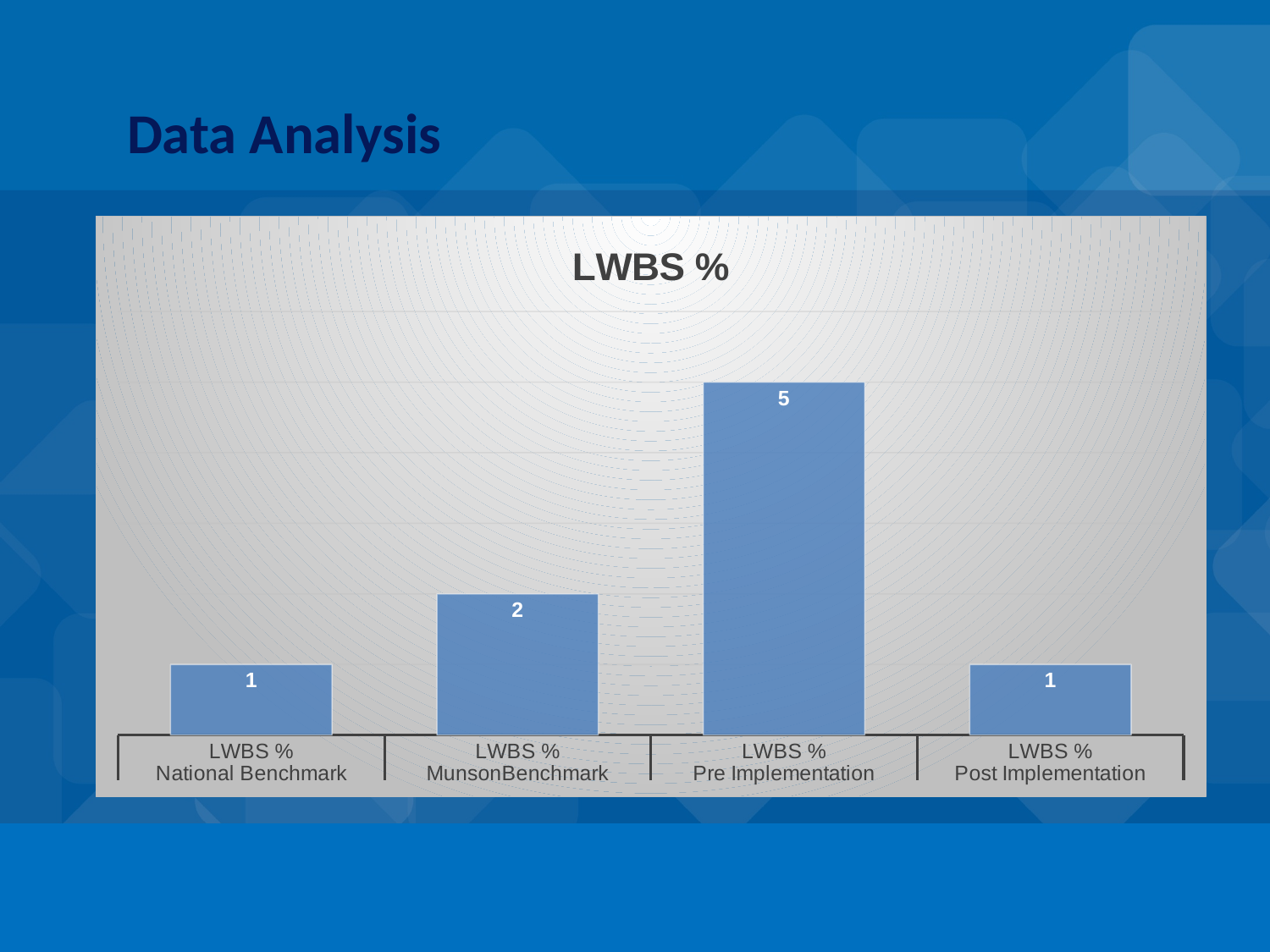
What is the value for LWBS % National Benchmark? 1 What is the value for LWBS % MunsonBenchmark? 2 Which category has the highest value? LWBS % Pre Implementation What is the title of the chart? LWBS % What is the value for LWBS % Post Implementation? 1 What kind of chart is shown on the slide? Bar chart Which is larger, the value for LWBS % MunsonBenchmark or LWBS % Post Implementation? LWBS % MunsonBenchmark How many categories are shown in the chart? 4 What is the total of all four values shown in the chart? 9 What is the difference between the values for LWBS % MunsonBenchmark and LWBS % National Benchmark? 1 What is the difference between the values for LWBS % Pre Implementation and LWBS % Post Implementation? 4 What is the value for LWBS % Pre Implementation? 5